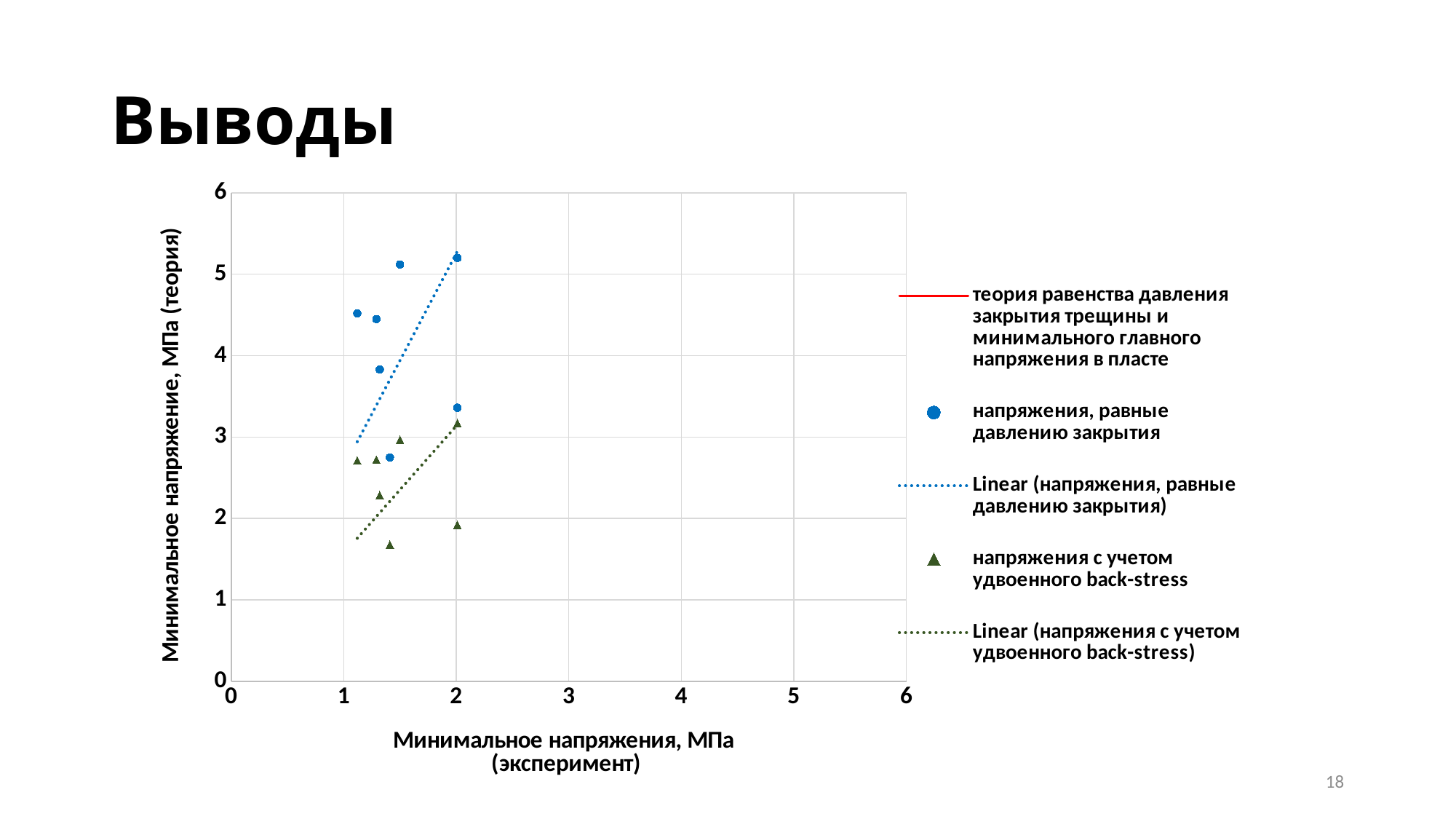
How many blue circle points (напряжения, равные давлению закрытия) are plotted on the chart? 7 What is the title of the horizontal axis of the chart? Минимальное напряжения, МПа (эксперимент) What is the maximum value shown on the vertical axis of the chart? 6 Is the lowest green triangle point on the chart greater or less than 2 on the vertical axis? less What kind of chart is shown on the slide? scatter chart Are all plotted points located at horizontal-axis values greater or less than 3? less How many entries does the chart legend list? 5 Does the dotted green linear trendline rise or fall as the horizontal-axis value increases? rise Is the highest blue circle point on the chart greater or less than 5 on the vertical axis? greater Does the dotted blue linear trendline rise or fall as the horizontal-axis value increases? rise How many green triangle points (напряжения с учетом удвоенного back-stress) are plotted on the chart? 7 Which series reaches higher values on the vertical axis: the blue circles or the green triangles? blue circles